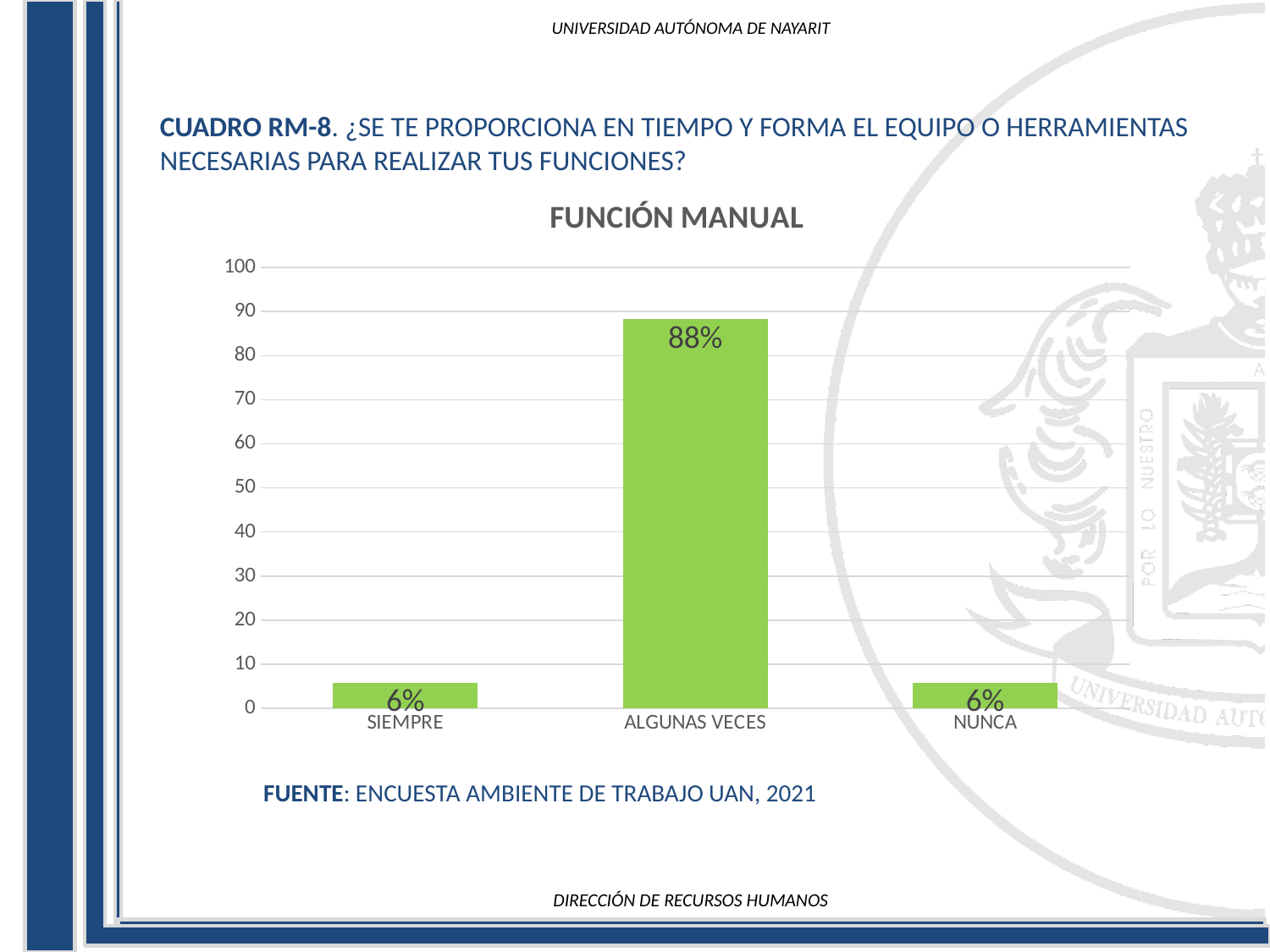
What is the difference between the values for ALGUNAS VECES and SIEMPRE? 82% What kind of chart is shown on the slide? bar chart What is the value for NUNCA? 6% What is the title of the chart? FUNCIÓN MANUAL Which category has the highest value? ALGUNAS VECES What is the value for SIEMPRE? 6% What is the value for ALGUNAS VECES? 88% Which is larger, the value for ALGUNAS VECES or the value for NUNCA? ALGUNAS VECES Is the value for ALGUNAS VECES greater or less than 80? greater Is the value for SIEMPRE greater or less than 10? less How many categories are shown on the x axis? 3 What is the highest value shown on the y axis? 100